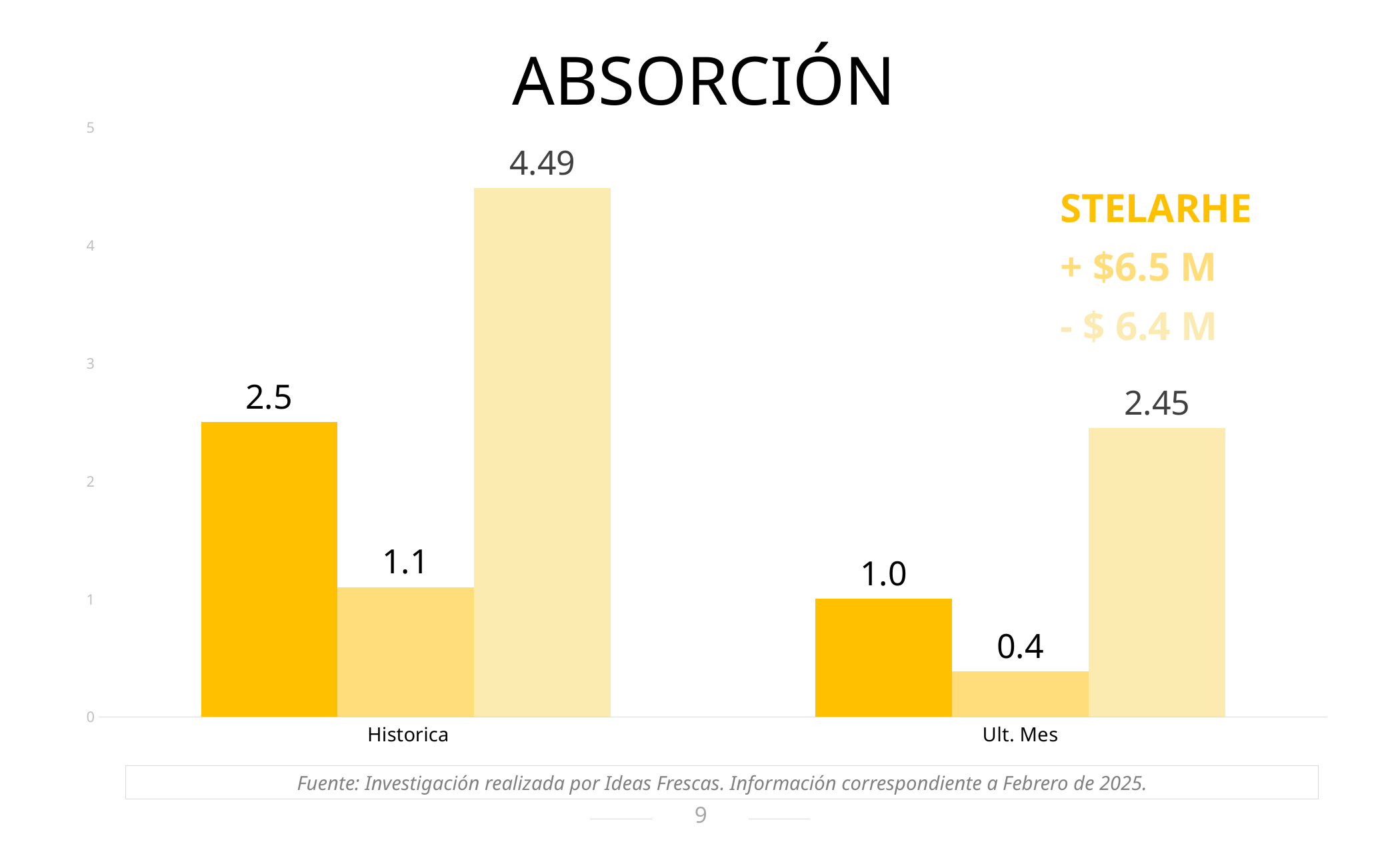
How many categories are shown on the x axis? 2 What is the value of the STELARHE bar for Historica? 2.5 How many series does the legend list? 3 What is the value of the "- $ 6.4 M" bar for Historica? 4.49 What type of chart is shown on the slide? Bar chart Which series has the lowest value in the Ult. Mes category? + $6.5 M Which is larger: the "+ $6.5 M" value for Historica or the STELARHE value for Ult. Mes? + $6.5 M for Historica Which series has the highest value in the Historica category? - $ 6.4 M What is the value of the STELARHE bar for Ult. Mes? 1.0 What is the value of the "+ $6.5 M" bar for Ult. Mes? 0.4 What is the difference between the STELARHE values for Historica and Ult. Mes? 1.5 What is the difference between the "- $ 6.4 M" value and the STELARHE value for Historica? 1.99